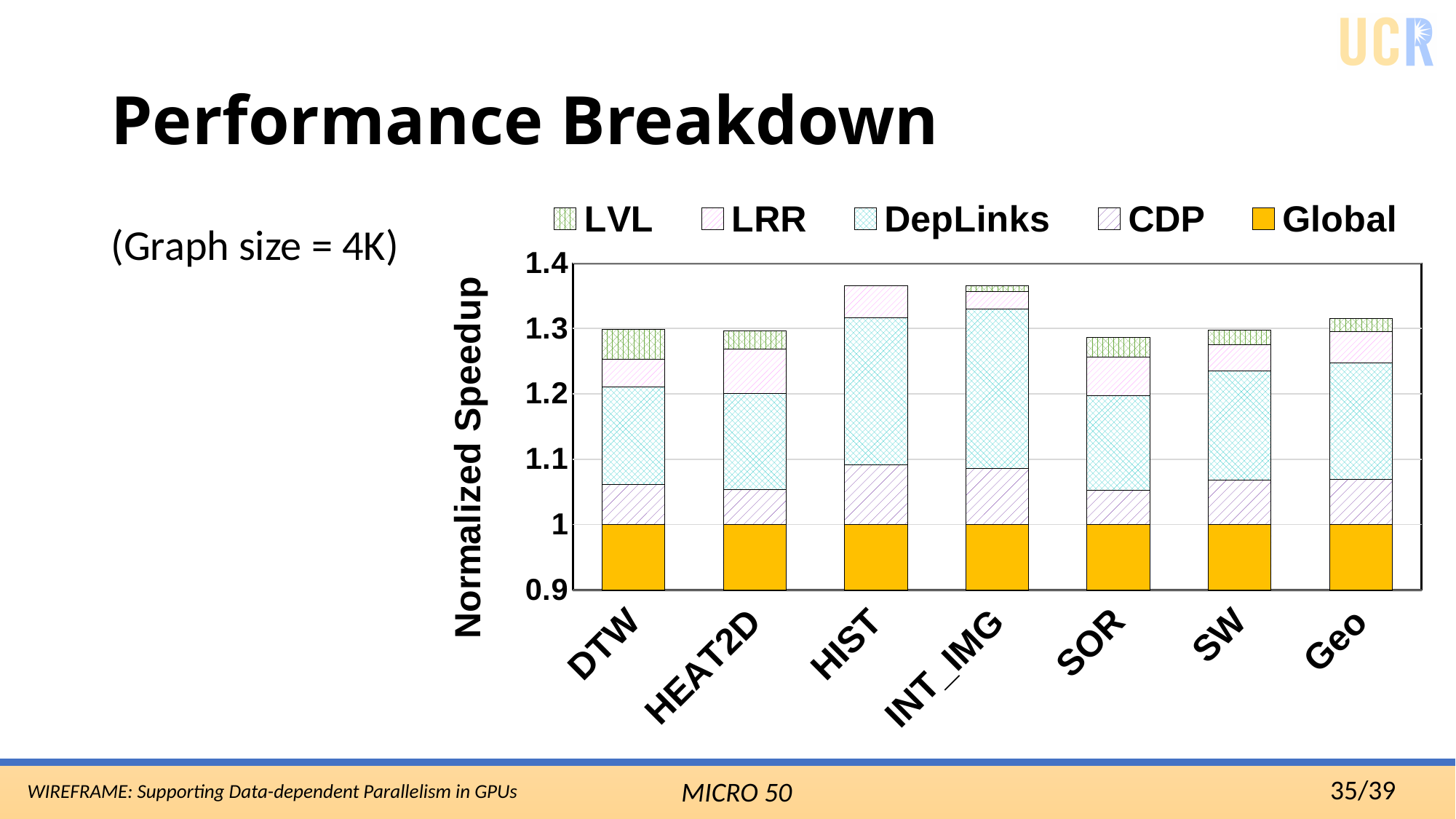
At what value does the Global segment of the DTW bar end? 1 Which series is drawn in solid orange? Global Is the total stacked value for SOR greater or less than 1.3? less Is the total stacked value for HIST greater or less than 1.3? greater How many series does the legend list? 5 How many categories (benchmarks) are shown on the x axis? 7 What kind of chart is shown on the slide? stacked bar chart Which has the larger total stacked value, Geo or SOR? Geo What is the label of the y axis? Normalized Speedup Is the total stacked value for HEAT2D greater or less than 1.2? greater Which has the larger total stacked value, HIST or HEAT2D? HIST